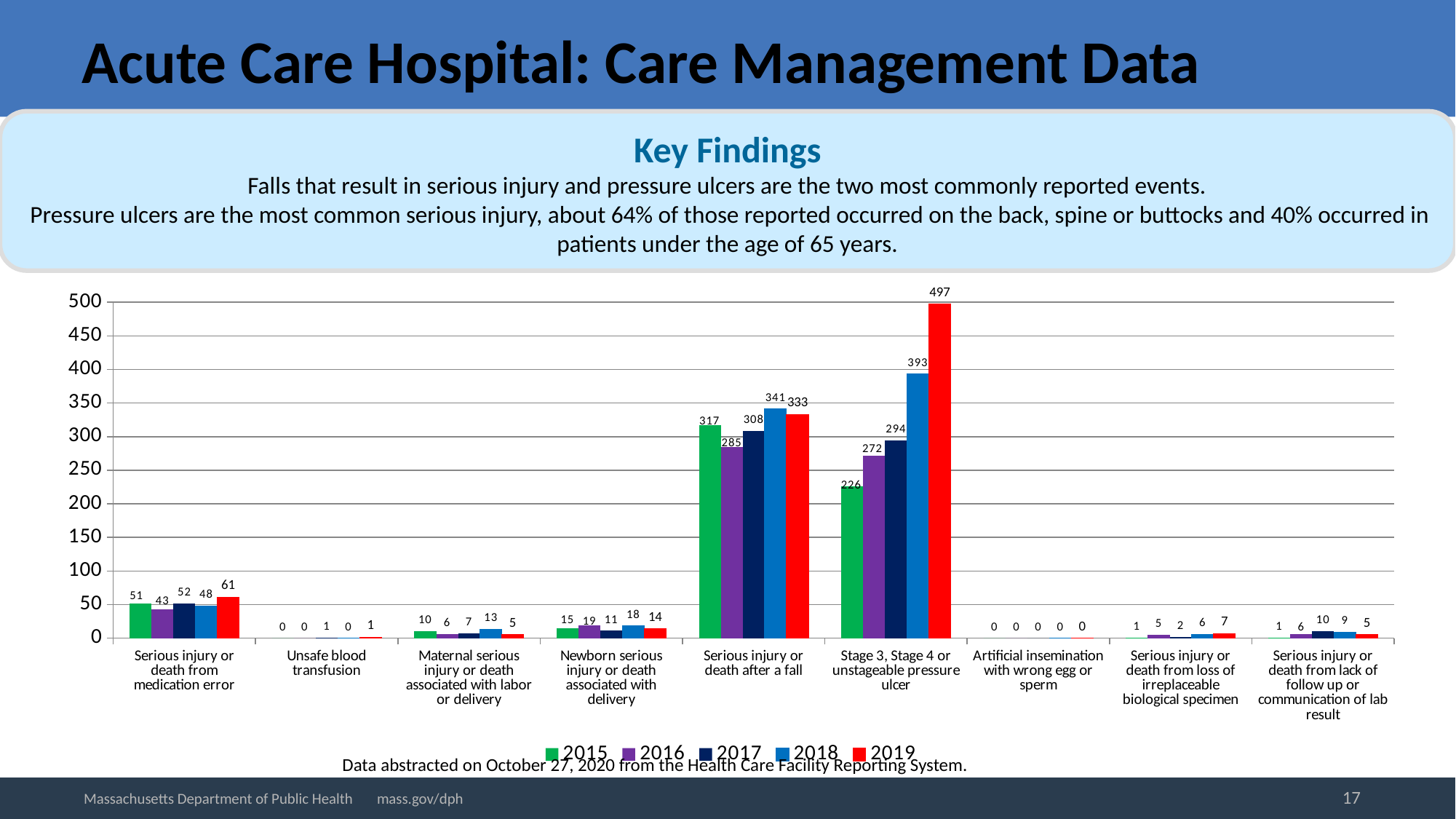
Which year has the highest value in the 'Stage 3, Stage 4 or unstageable pressure ulcer' category? 2019 What is the value for 2015 in the 'Serious injury or death after a fall' category? 317 What is the value for 2018 in the 'Serious injury or death from medication error' category? 48 Which year has the lowest value in the 'Serious injury or death after a fall' category? 2016 Is the 2017 value for 'Serious injury or death after a fall' greater or less than 300? greater Which is larger: the 2018 value for 'Serious injury or death after a fall' or the 2018 value for 'Stage 3, Stage 4 or unstageable pressure ulcer'? Stage 3, Stage 4 or unstageable pressure ulcer What is the difference between the 2019 and 2015 values for 'Stage 3, Stage 4 or unstageable pressure ulcer'? 271 What is the value for 2019 in the 'Stage 3, Stage 4 or unstageable pressure ulcer' category? 497 Do the values for 'Stage 3, Stage 4 or unstageable pressure ulcer' rise or fall from 2015 to 2019? Rise What kind of chart is shown on the slide? Bar chart How many categories are shown on the x axis? 9 How many series does the legend list? 5